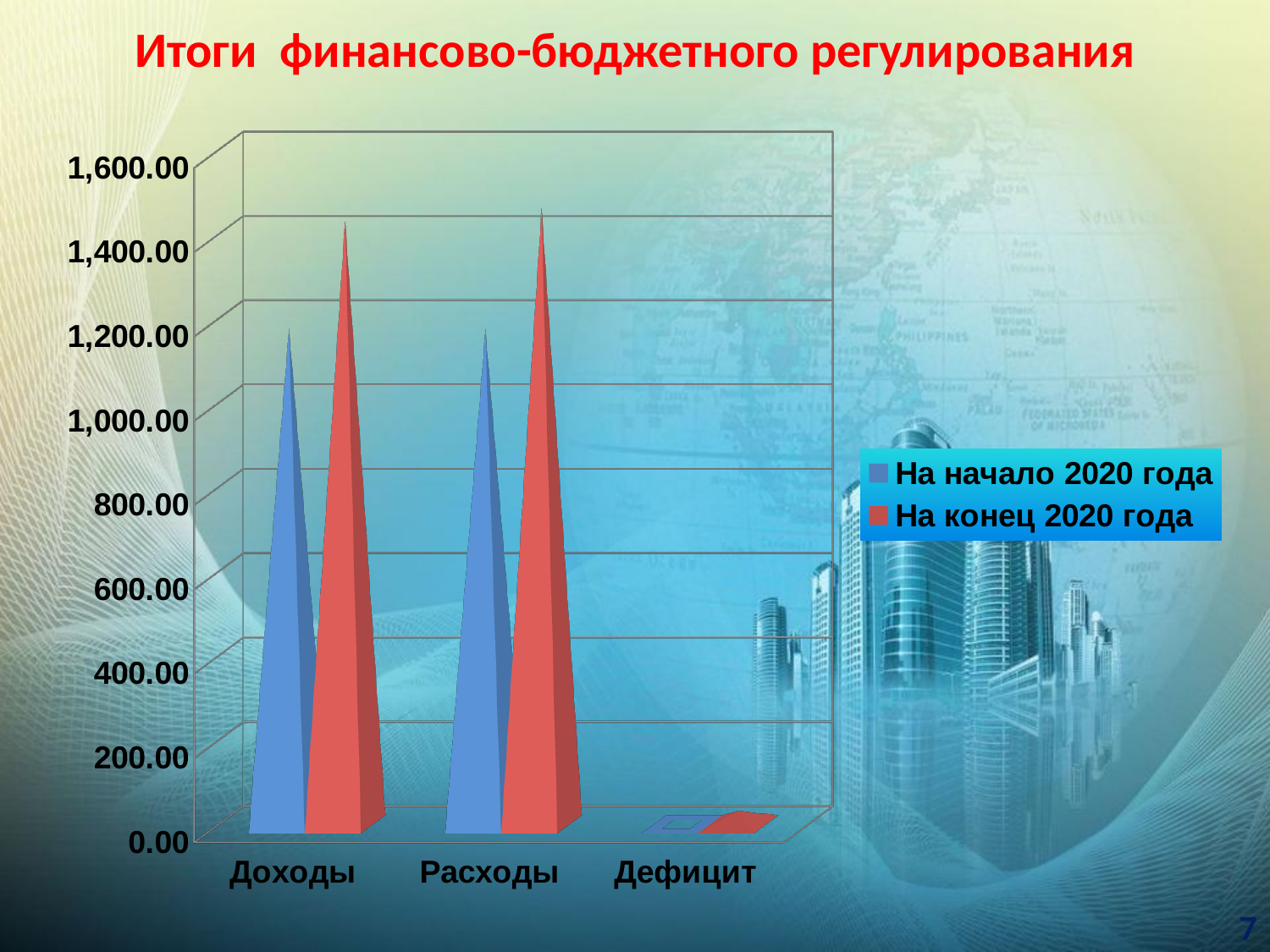
How many series does the chart's legend list? 2 How many categories are shown on the x axis of the chart? 3 Which category has the lowest value for the series 'На начало 2020 года'? Дефицит For the category 'Расходы', which series has the larger value: 'На начало 2020 года' or 'На конец 2020 года'? На конец 2020 года Which category has the lowest value for the series 'На конец 2020 года'? Дефицит For the category 'Доходы', which series has the larger value: 'На начало 2020 года' or 'На конец 2020 года'? На конец 2020 года What kind of chart is shown on the slide? bar chart Which colour represents the series 'На конец 2020 года' in the chart? red What is the title of the slide containing the chart? Итоги финансово-бюджетного регулирования Is the value for 'Доходы' in the series 'На начало 2020 года' greater or less than 1,000.00? greater Is the value for 'Дефицит' in the series 'На конец 2020 года' greater or less than 200.00? less Is the value for 'Расходы' in the series 'На конец 2020 года' greater or less than 1,200.00? greater